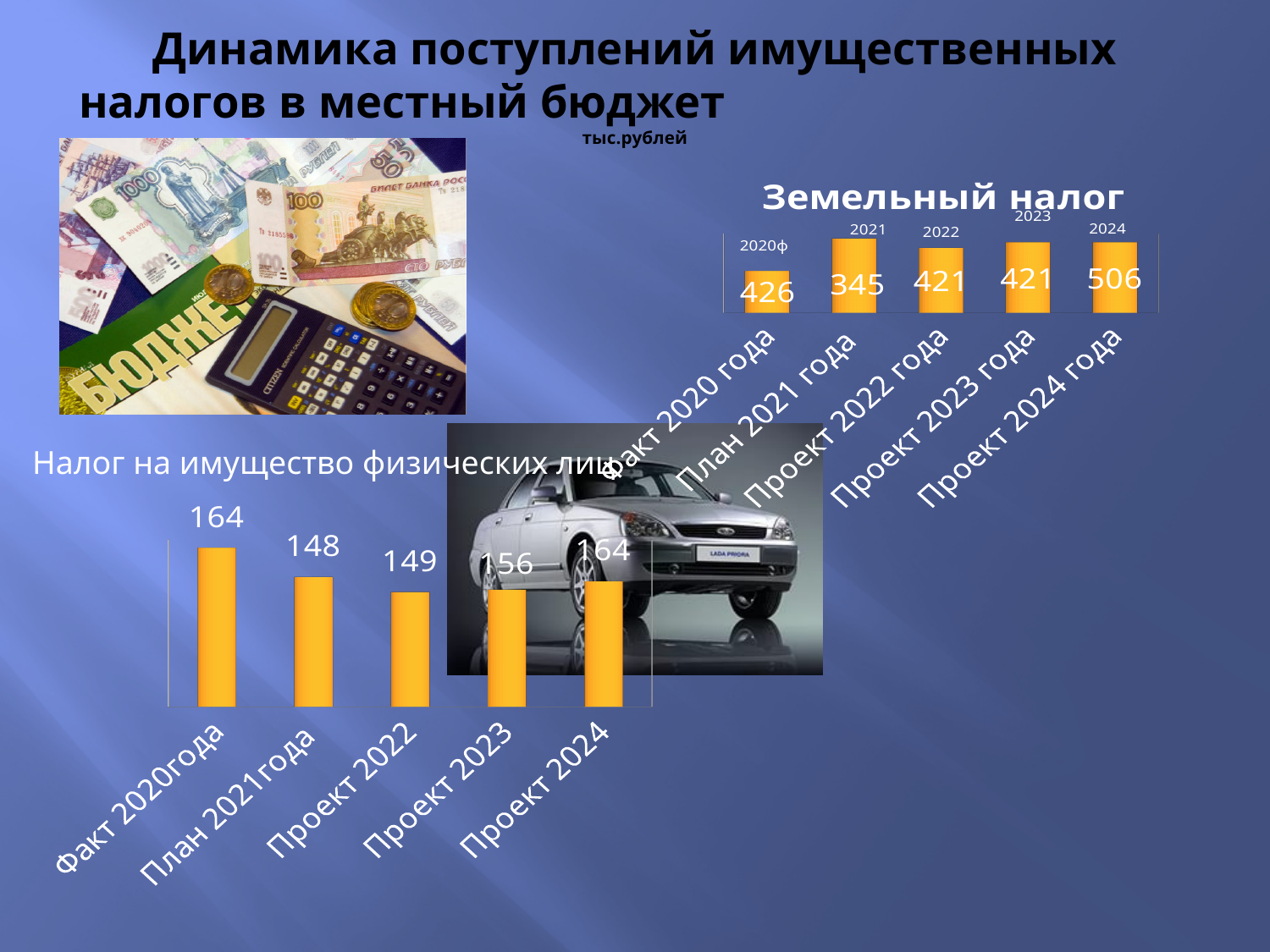
What type of chart is the 'Налог на имущество физических лиц' chart? Bar chart In the 'Налог на имущество физических лиц' chart, what is the value for План 2021года? 148 In the 'Земельный налог' chart, how many categories are shown? 5 In the 'Земельный налог' chart, which category has the lowest value? План 2021 года In the 'Земельный налог' chart, what is the difference between Проект 2024 года and Факт 2020 года? 80 In the 'Налог на имущество физических лиц' chart, which category has the lowest value? План 2021года In the 'Налог на имущество физических лиц' chart, what is the value for Проект 2023? 156 In the 'Земельный налог' chart, what is the value for Проект 2024 года? 506 In the 'Земельный налог' chart, which category has the highest value? Проект 2024 года In the 'Налог на имущество физических лиц' chart, what is the difference between Факт 2020года and План 2021года? 16 In the 'Земельный налог' chart, what is the value for План 2021 года? 345 In the 'Налог на имущество физических лиц' chart, which is larger: Проект 2022 or Проект 2023? Проект 2023